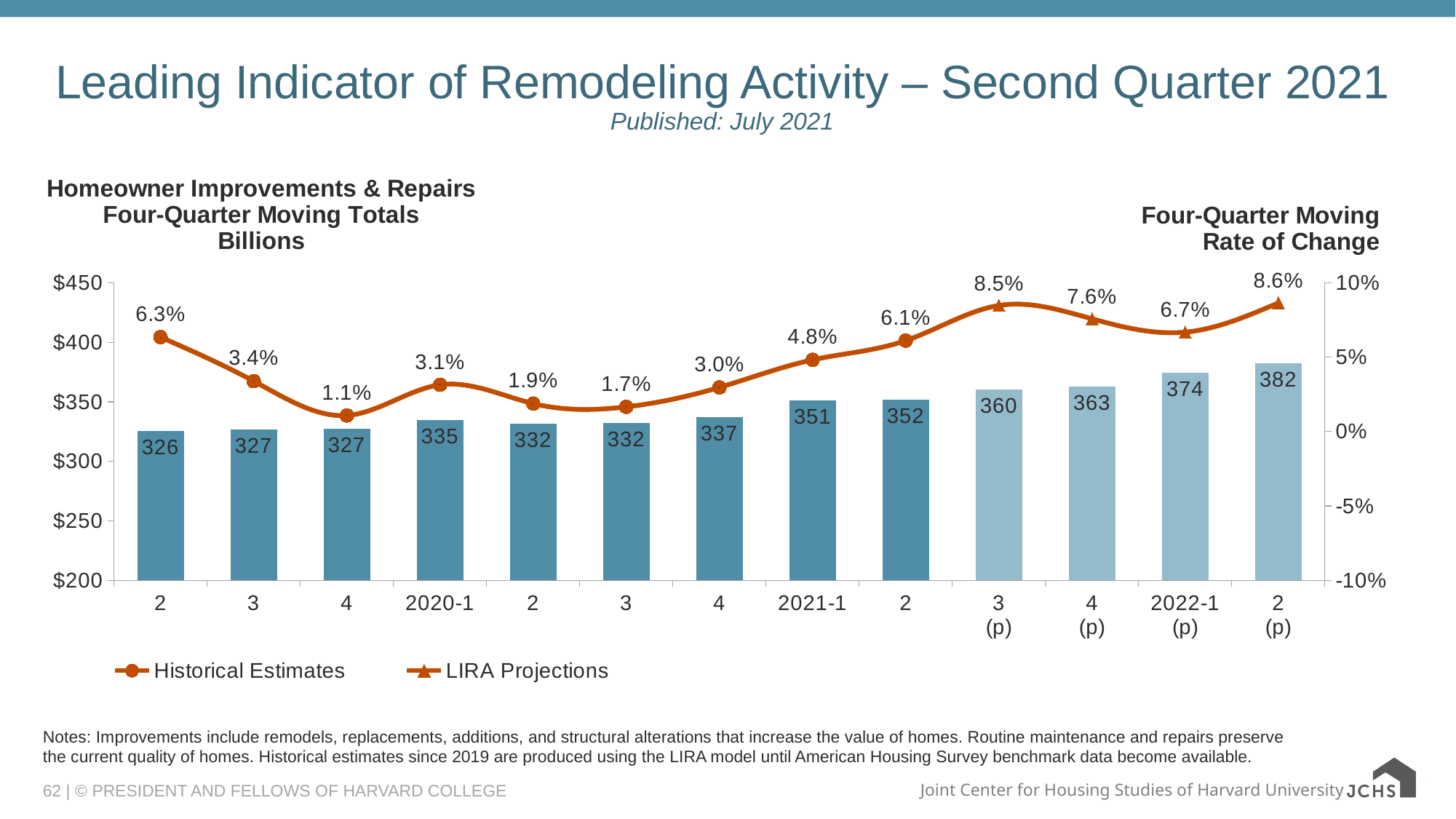
What are the two entries in the legend? Historical Estimates and LIRA Projections Which is larger, the rate of change for 3 (p) of 2021 or for 4 (p) of 2021? 3 (p), 8.5% Which quarter has the highest four-quarter moving total? 2 (p) (2022), 382 Which quarter has the highest four-quarter moving rate of change? 2 (p) (2022), 8.6% What is the four-quarter moving rate of change for 2020-1? 3.1% What kind of chart is this? Combined bar and line chart What is the difference between the four-quarter moving totals for 2 (p) of 2022 and 2021-1? 31 How many series does the legend list? 2 Which quarter has the lowest four-quarter moving rate of change? 4 (2019), 1.1% What is the four-quarter moving total (in billions) for 2021-1? 351 How many quarters are shown on the x axis? 13 What is the projected four-quarter moving total for 2022-1 (p)? 374